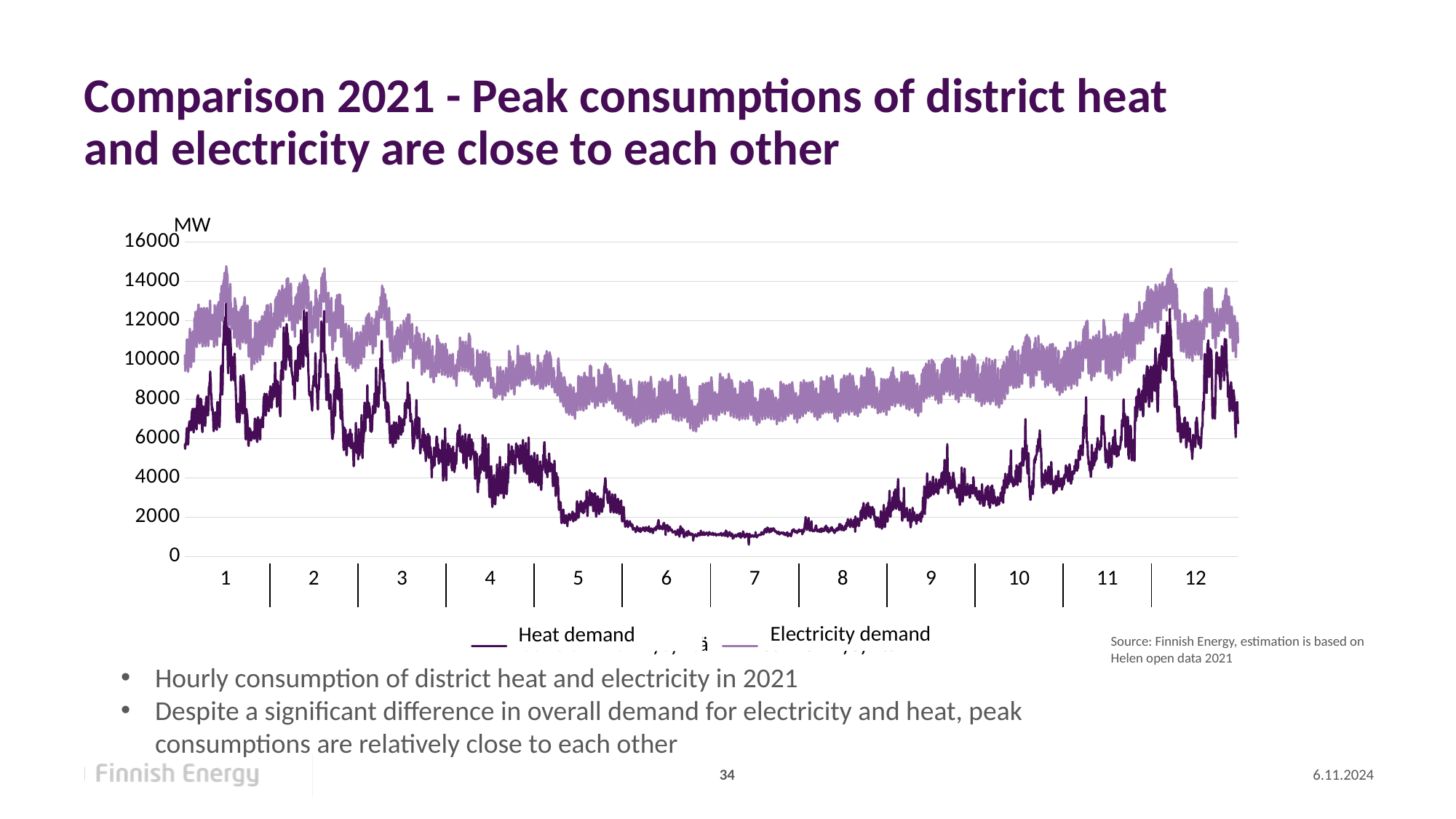
In month 7, which series is higher, Heat demand or Electricity demand? Electricity demand How many months are labelled along the x axis of the chart? 12 Does Heat demand rise or fall from month 1 to month 7? fall How many series does the chart's legend list? 2 Is the Electricity demand in month 7 greater or less than 6000 MW? greater Does Heat demand rise or fall from month 7 to month 12? rise What kind of chart is shown on the slide? Line chart Is the Electricity demand in month 1 greater or less than 10000 MW? greater What unit is shown on the chart's vertical axis? MW What are the two series named in the chart's legend? Heat demand and Electricity demand In which month is Heat demand at its lowest? 7 Is the Heat demand in month 7 greater or less than 2000 MW? less